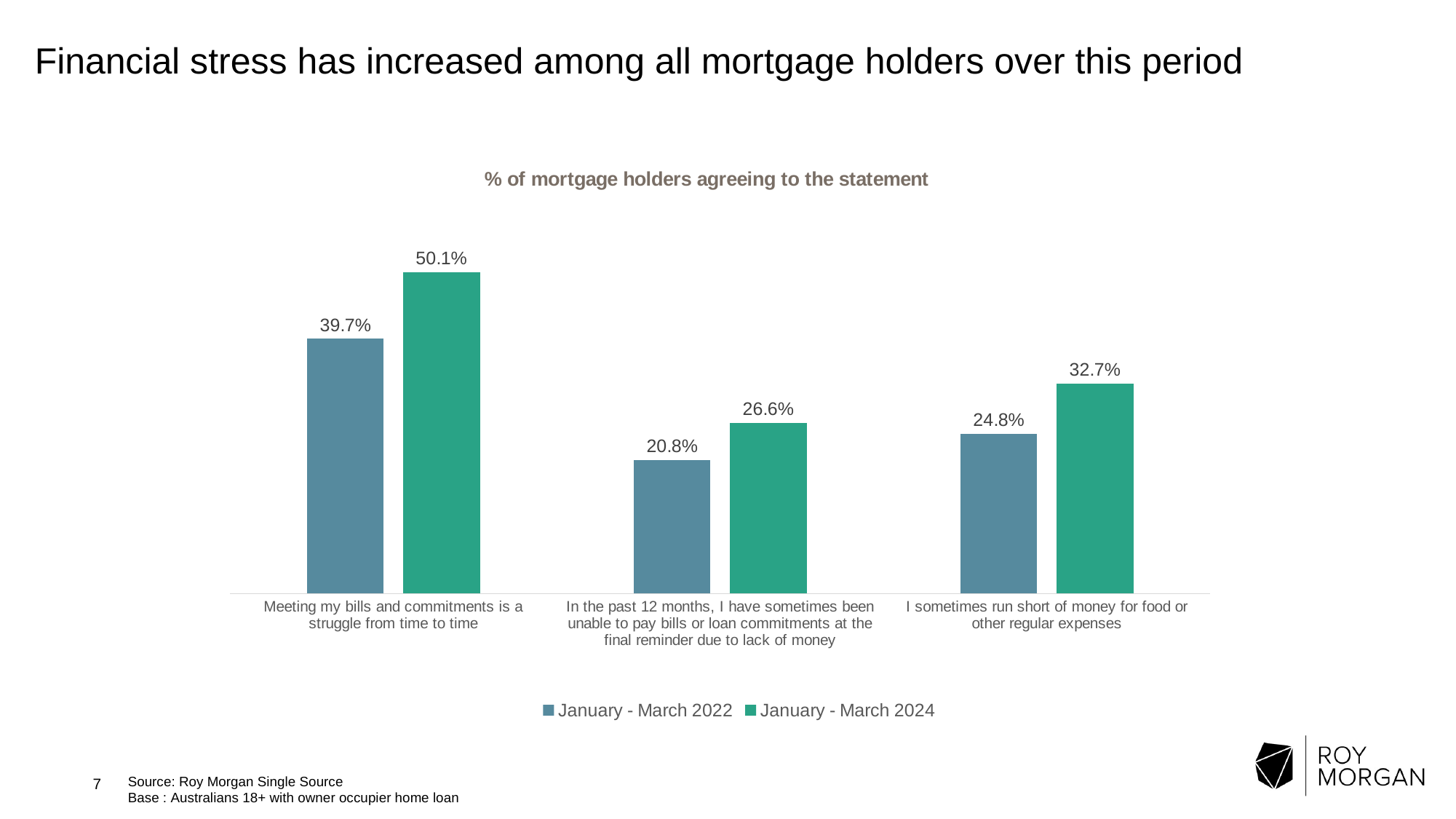
How many series does the legend list? 2 What percentage of mortgage holders agreed that 'Meeting my bills and commitments is a struggle from time to time' in January - March 2022? 39.7% What type of chart is shown on the slide? Bar chart By how many percentage points did agreement with 'Meeting my bills and commitments is a struggle from time to time' increase from January - March 2022 to January - March 2024? 10.4 percentage points What is the January - March 2024 value for 'I sometimes run short of money for food or other regular expenses'? 32.7% What percentage of mortgage holders agreed that 'Meeting my bills and commitments is a struggle from time to time' in January - March 2024? 50.1% Which statement has the highest percentage of mortgage holders agreeing in January - March 2024? Meeting my bills and commitments is a struggle from time to time How many statements (categories) are shown on the chart? 3 What is the January - March 2022 value for 'In the past 12 months, I have sometimes been unable to pay bills or loan commitments at the final reminder due to lack of money'? 20.8% Which statement has the lowest percentage of mortgage holders agreeing in January - March 2022? In the past 12 months, I have sometimes been unable to pay bills or loan commitments at the final reminder due to lack of money For 'In the past 12 months, I have sometimes been unable to pay bills or loan commitments at the final reminder due to lack of money', which period has the larger value: January - March 2022 or January - March 2024? January - March 2024 What is the difference between the January - March 2024 and January - March 2022 values for 'I sometimes run short of money for food or other regular expenses'? 7.9 percentage points